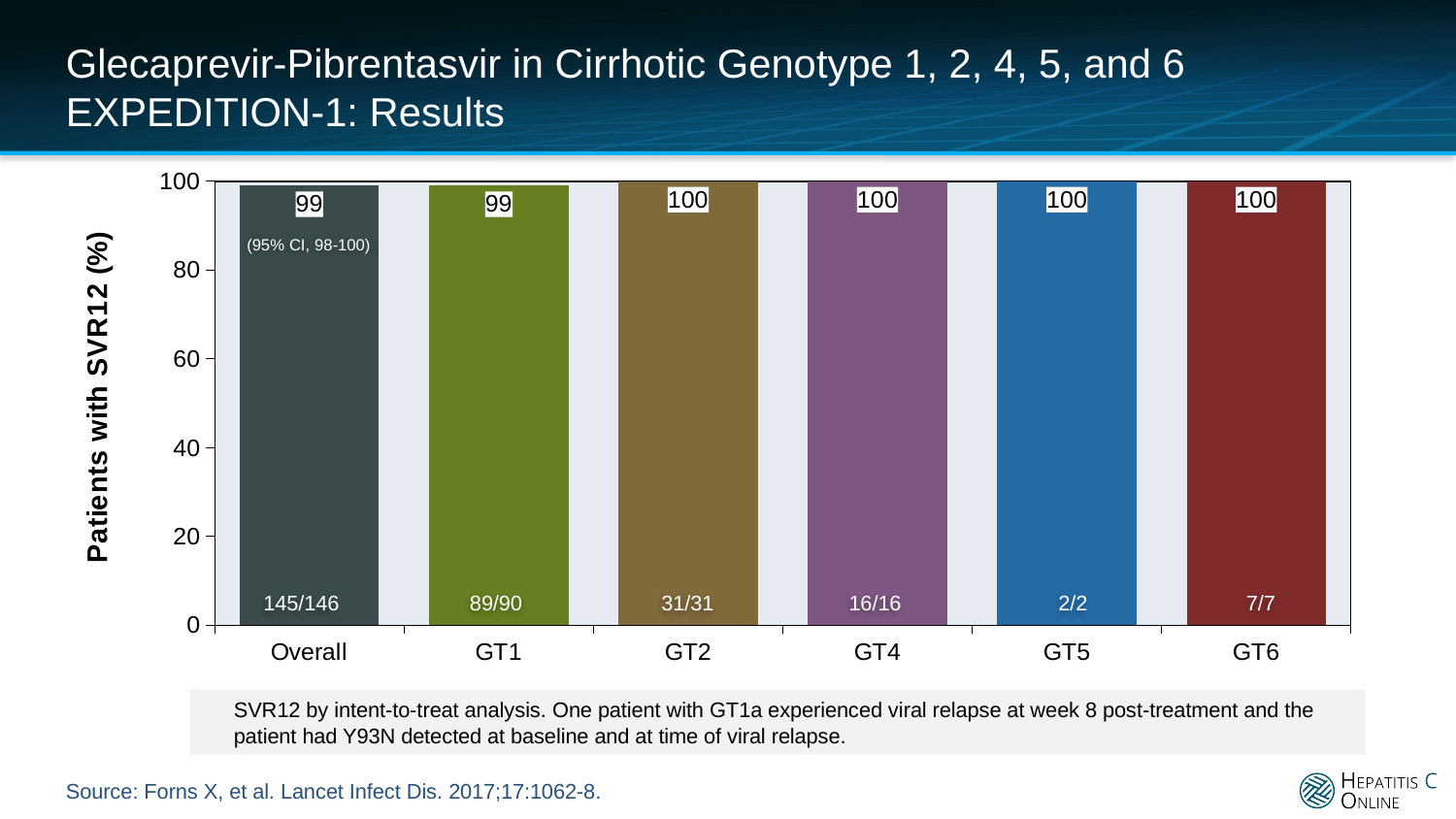
Is the SVR12 rate for GT6 greater or less than 80? greater What fraction of patients is shown at the base of the Overall bar? 145/146 What kind of chart is shown on the slide? Bar chart How many categories are shown on the x axis? 6 What is the difference between the SVR12 rate for GT4 and the SVR12 rate for GT1? 1 What is the label of the y axis? Patients with SVR12 (%) What fraction of patients is shown at the base of the GT1 bar? 89/90 What is the 95% confidence interval shown for the Overall group? 98-100 What fraction of patients is shown at the base of the GT5 bar? 2/2 What is the SVR12 rate for GT2? 100 What is the SVR12 rate for GT1? 99 What is the SVR12 rate for the Overall group? 99